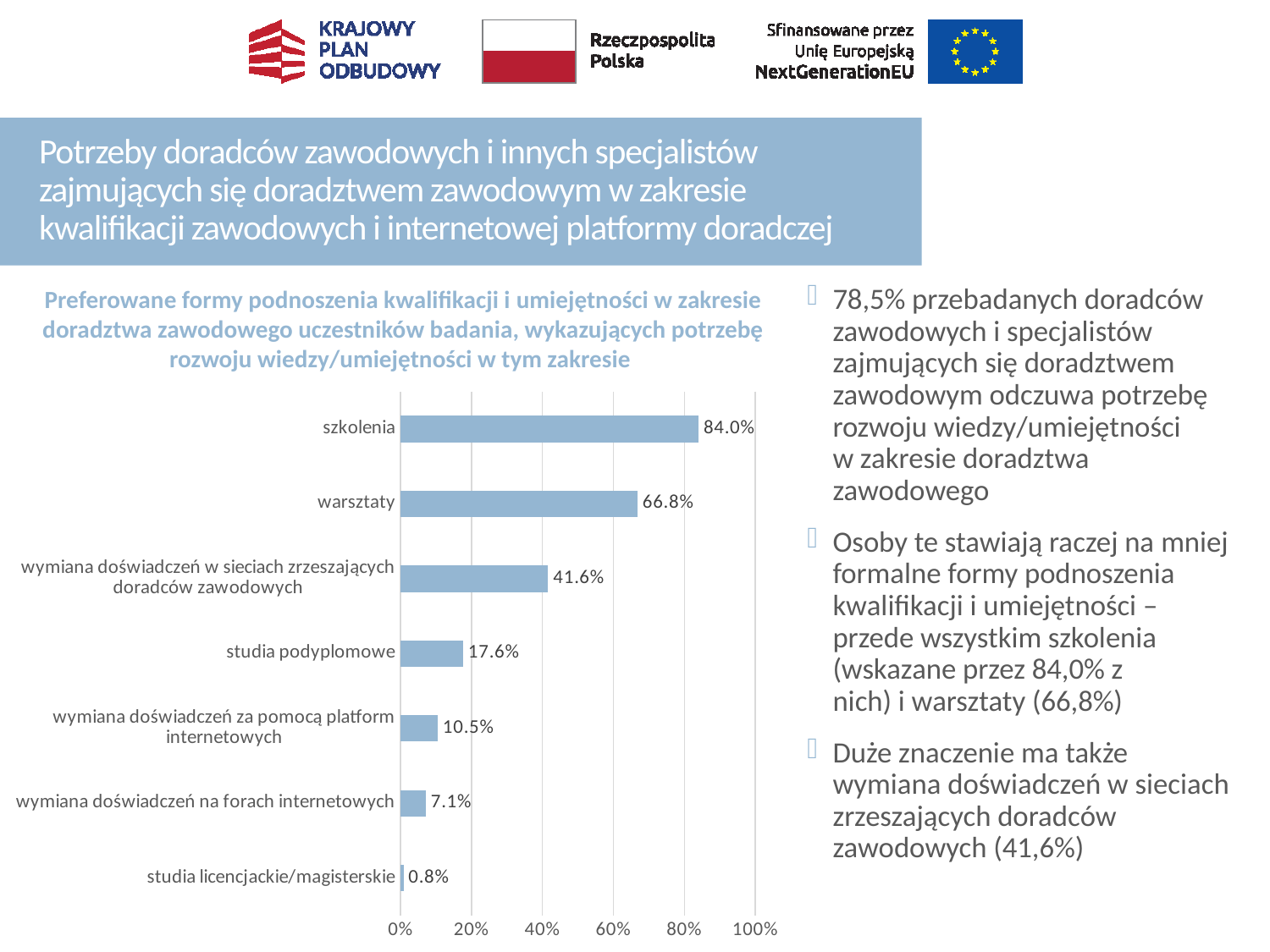
Which is larger, the value for studia podyplomowe or the value for wymiana doświadczeń za pomocą platform internetowych? studia podyplomowe Is the value for wymiana doświadczeń w sieciach zrzeszających doradców zawodowych greater or less than 40%? greater What is the difference between the values for szkolenia and warsztaty? 17.2% What kind of chart is shown on the slide? bar chart What is the value for szkolenia? 84.0% What is the highest tick label on the horizontal axis? 100% What is the value for warsztaty? 66.8% What is the value for wymiana doświadczeń na forach internetowych? 7.1% How many categories are shown in the chart? 7 Which category has the lowest value? studia licencjackie/magisterskie Which category has the highest value? szkolenia What is the value for studia podyplomowe? 17.6%